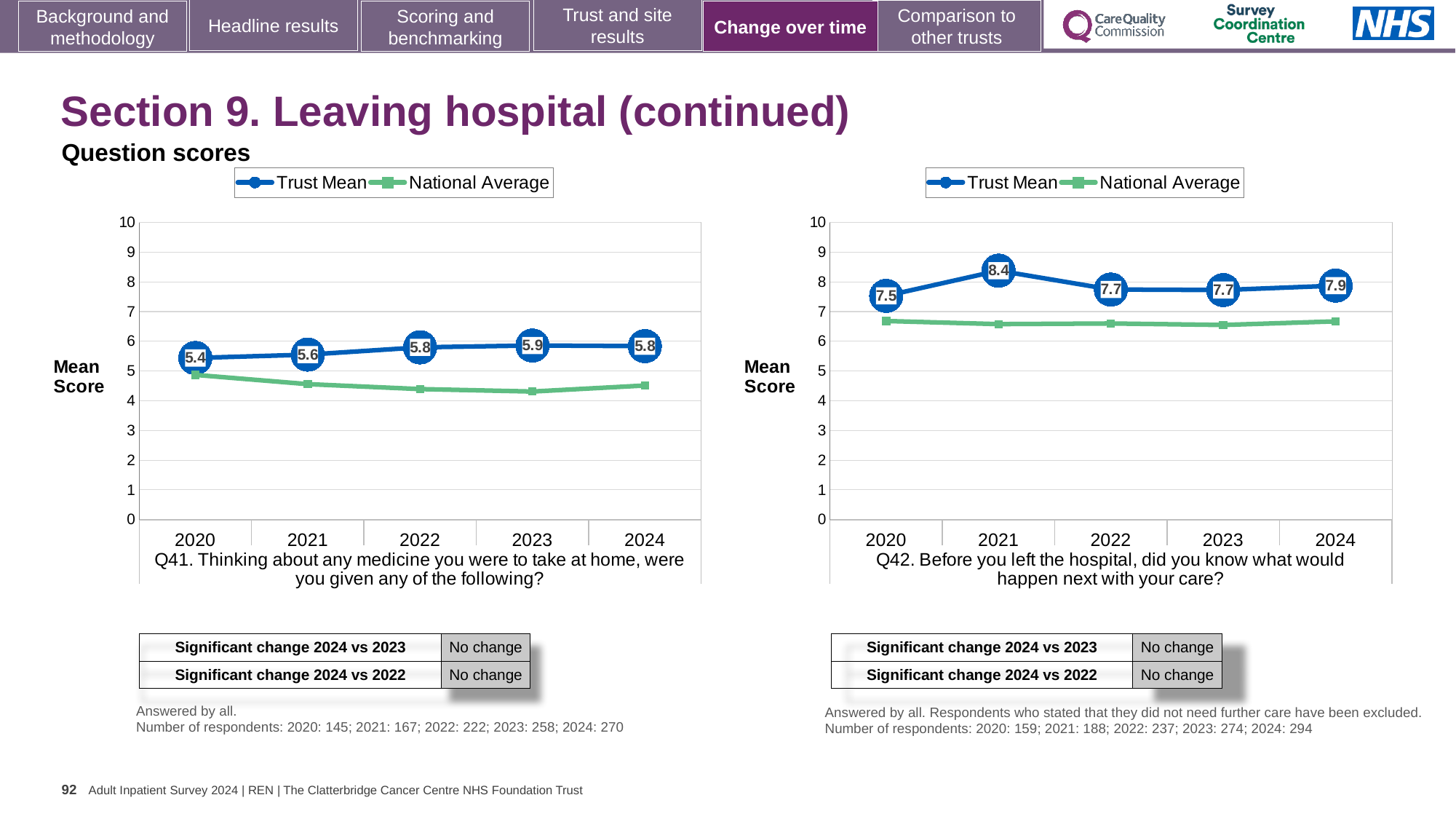
In the Q41 chart (left), is the Trust Mean for 2024 higher or lower than the Trust Mean for 2020? higher In the Q42 chart (right), is the National Average for 2020 greater or less than 6? greater In the Q42 chart (right), which year has the highest Trust Mean score? 2021 How many years are shown on the x axis of the Q42 chart (right)? 5 In the Q41 chart (left), is the National Average for 2023 greater or less than 5? less In the Q42 chart (right), what is the difference between the Trust Mean scores for 2021 and 2020? 0.9 In the Q41 chart (left), what is the Trust Mean score for 2023? 5.9 In the Q41 chart (left), what is the difference between the Trust Mean scores for 2023 and 2020? 0.5 What type of chart is used for Q41 (left)? Line chart In the Q41 chart (left), which year has the lowest Trust Mean score? 2020 In the Q42 chart (right), what is the Trust Mean score for 2021? 8.4 How many series does the legend of the Q41 chart (left) list? 2